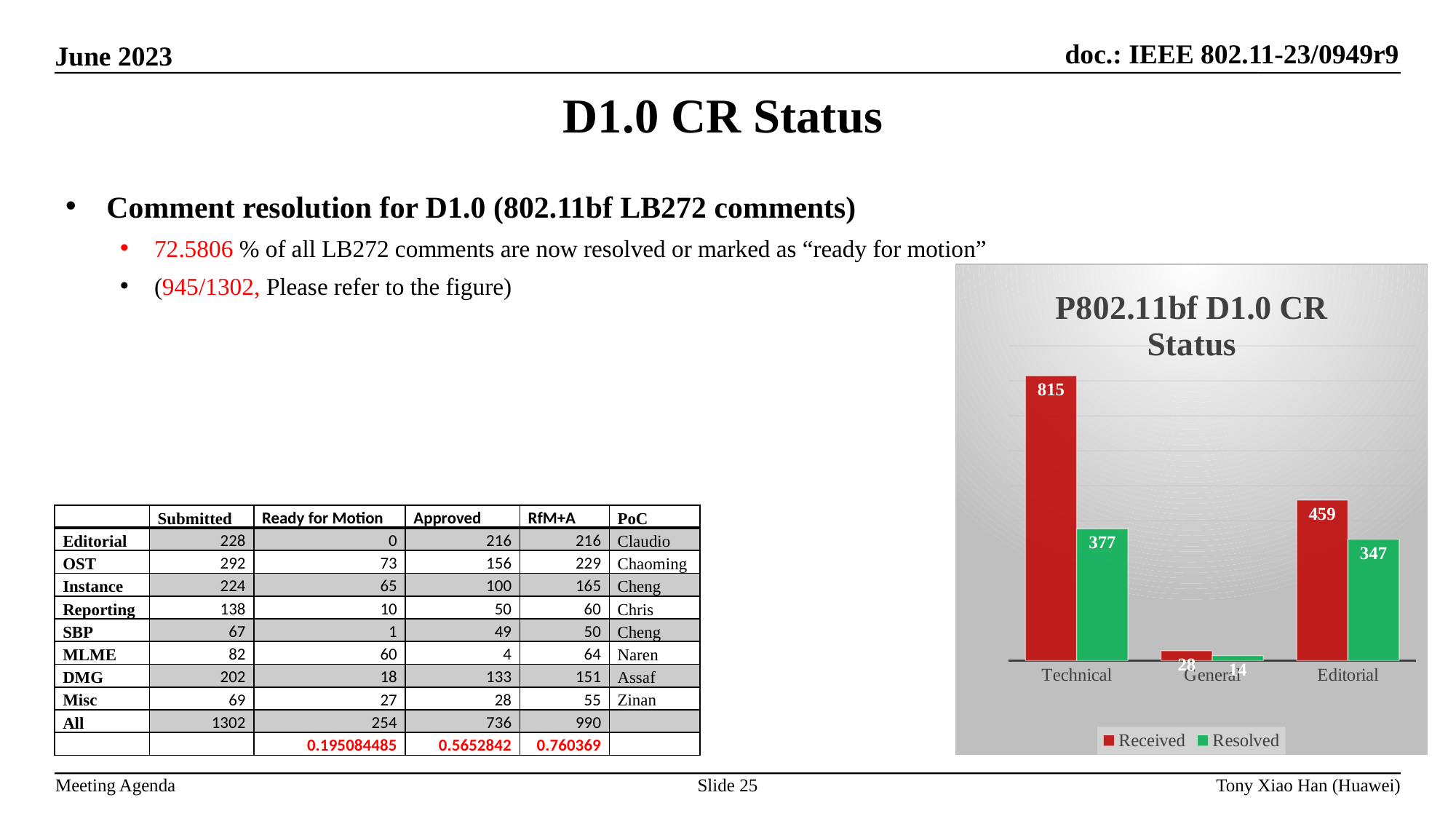
What is the difference between Received and Resolved for Technical in the P802.11bf D1.0 CR Status chart? 438 How many categories are shown on the x axis of the P802.11bf D1.0 CR Status chart? 3 In the P802.11bf D1.0 CR Status chart, is the Resolved value for Technical or the Resolved value for Editorial larger? Technical What is the Resolved value for Editorial in the P802.11bf D1.0 CR Status chart? 347 Which category has the highest Received value in the P802.11bf D1.0 CR Status chart? Technical What is the difference between Received and Resolved for Editorial in the P802.11bf D1.0 CR Status chart? 112 What kind of chart is the P802.11bf D1.0 CR Status chart? Bar chart What is the Received value for Technical in the P802.11bf D1.0 CR Status chart? 815 What is the Resolved value for General in the P802.11bf D1.0 CR Status chart? 14 What is the Received value for Editorial in the P802.11bf D1.0 CR Status chart? 459 How many series does the legend of the P802.11bf D1.0 CR Status chart list? 2 Which category has the lowest Resolved value in the P802.11bf D1.0 CR Status chart? General